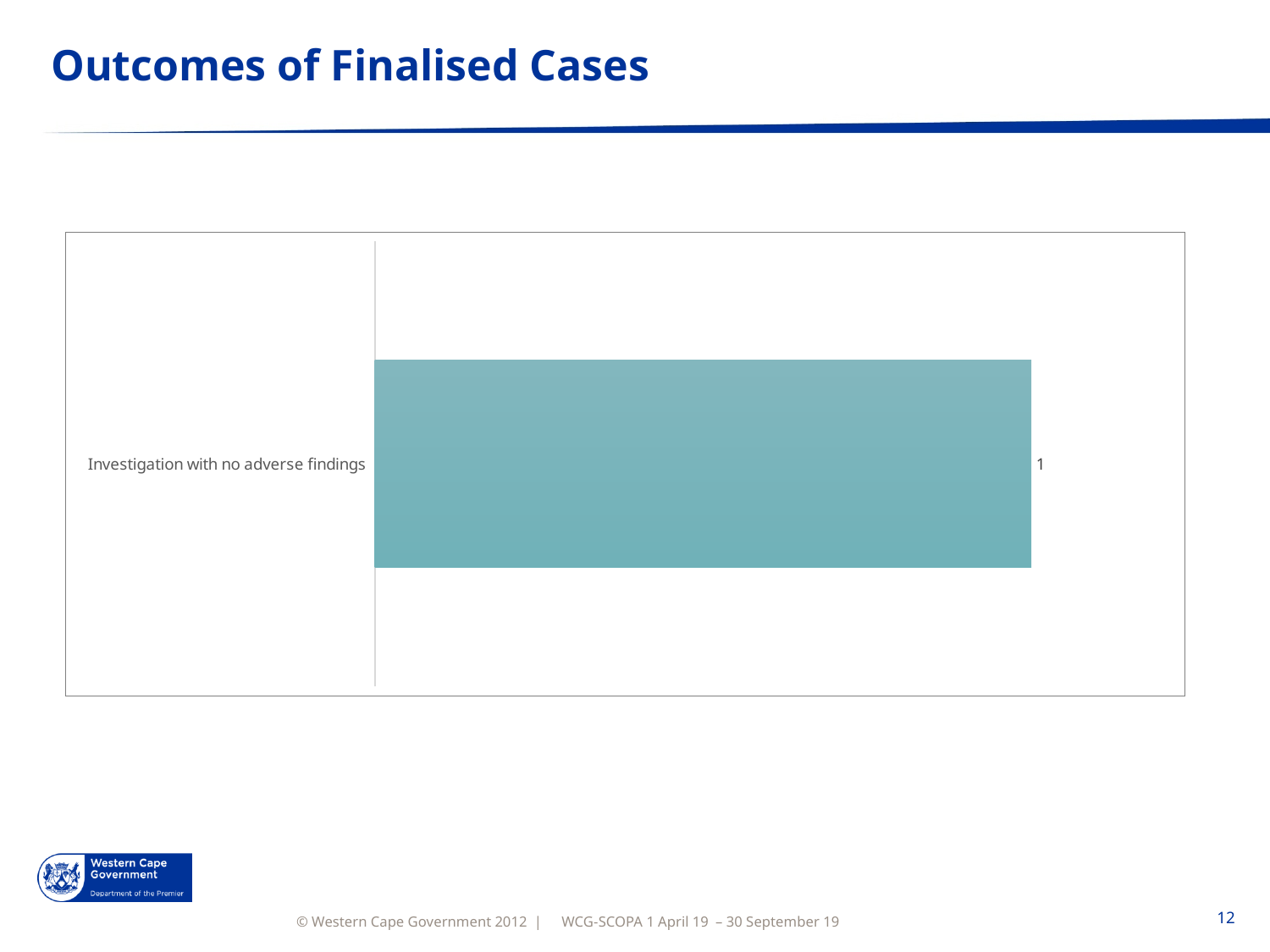
What is the label of the only category shown in the chart? Investigation with no adverse findings How many categories are plotted in the chart? 1 What kind of chart is shown on the slide? bar chart What is the value for "Investigation with no adverse findings"? 1 What is the title of the slide containing the chart? Outcomes of Finalised Cases Are the bars in the chart horizontal or vertical? horizontal